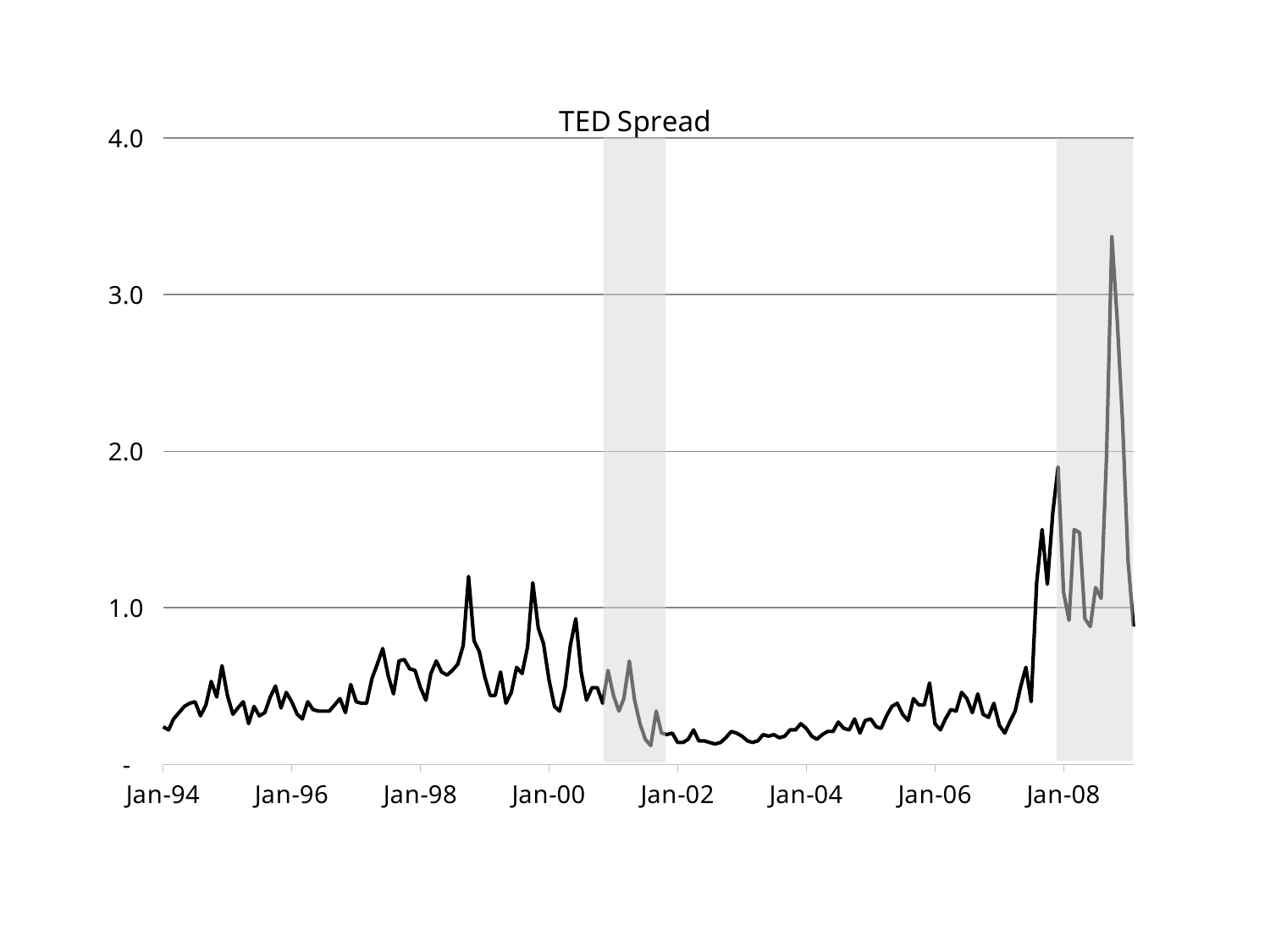
Is the highest value of the TED Spread line greater or less than 3.0? greater How many year labels are shown on the x axis? 8 What is the title of the chart? TED Spread Is the value of the TED Spread at Jan-94 greater or less than 1.0? less Does the TED Spread rise or fall between Jan-06 and Jan-08? rise What is the highest value shown on the y axis? 4.0 Does the TED Spread rise or fall between Jan-00 and Jan-02? fall What kind of chart is shown on the slide? line chart In which period does the TED Spread reach its highest peak: before Jan-02 or after Jan-08? after Jan-08 Is the value of the TED Spread at Jan-04 greater or less than 1.0? less Which is larger: the TED Spread at Jan-08 or at Jan-04? Jan-08